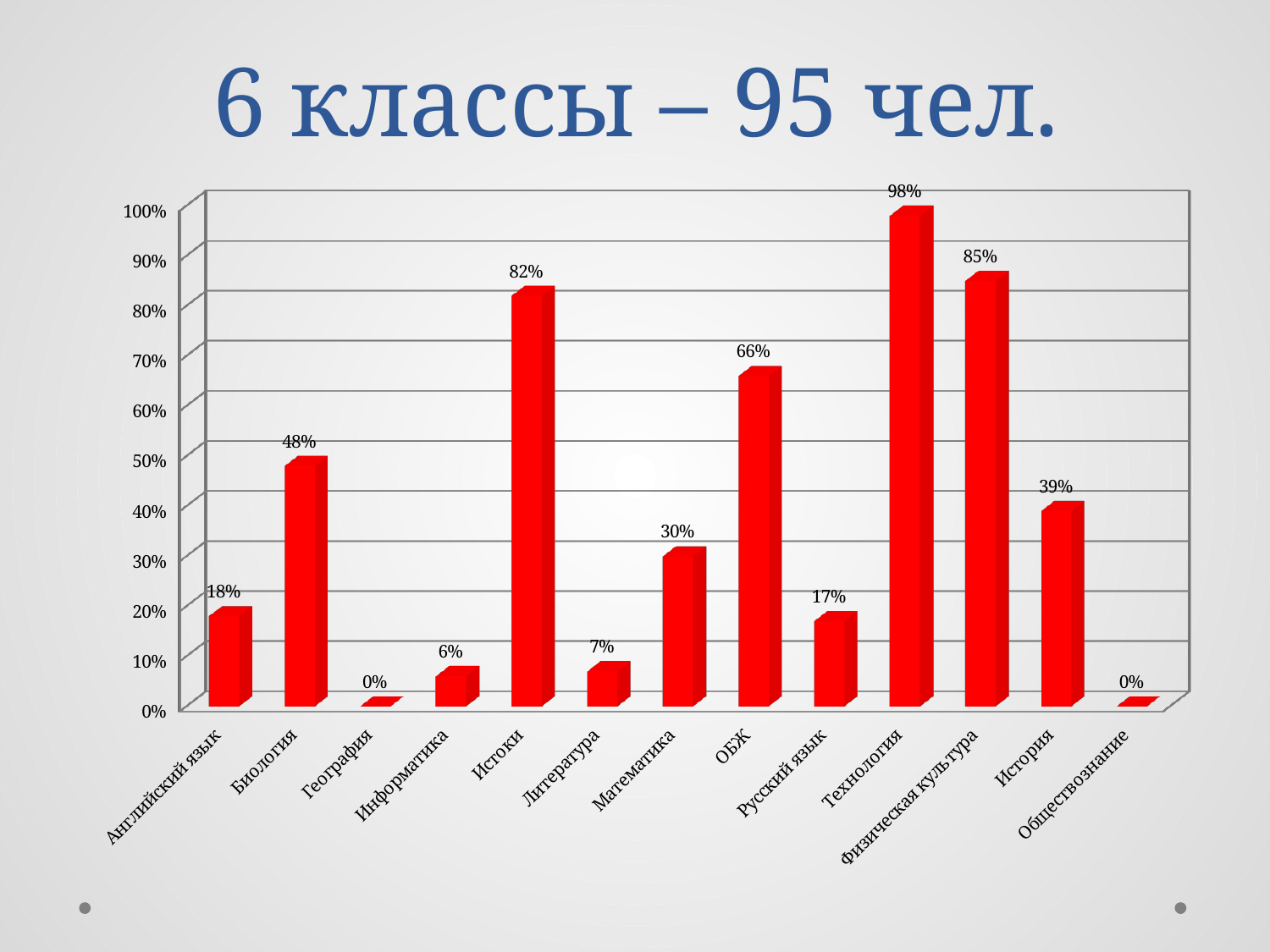
What is the value for Технология? 98% Which categories have the lowest value? География and Обществознание What is the difference between the values for Физическая культура and История? 46% What is the title of the slide? 6 классы – 95 чел. What is the value for Математика? 30% What kind of chart is shown on the slide? Bar chart What colour are the bars in the chart? Red How many categories are shown on the x axis? 13 Which is larger, the value for Биология or the value for ОБЖ? ОБЖ What is the value for Истоки? 82% Which category has the highest value? Технология What is the value for Русский язык? 17%